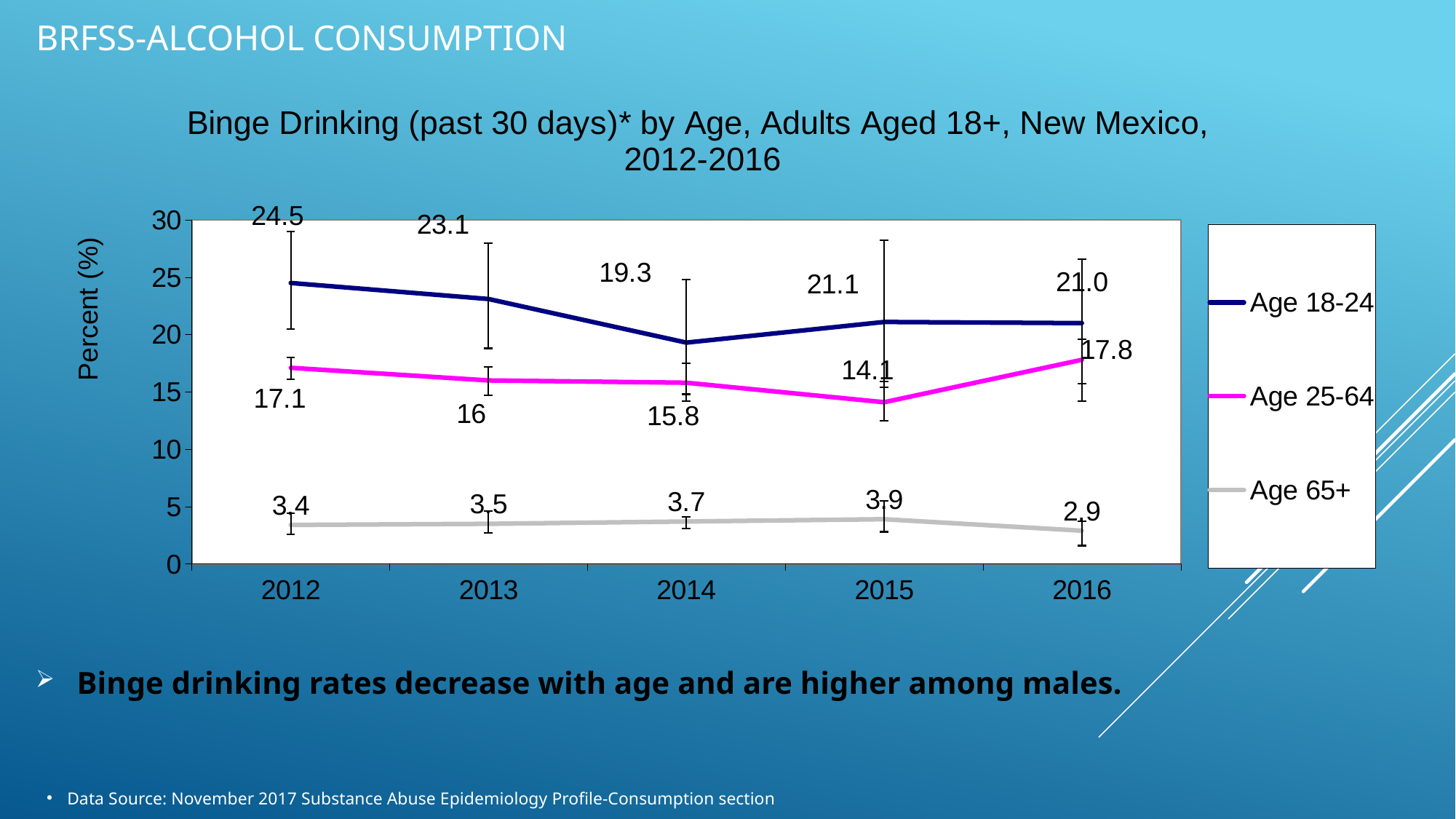
How many series does the legend list? 3 What was the binge drinking percentage for Age 25-64 in 2015? 14.1 Is the Age 25-64 value in 2012 greater or less than 15? greater What is the difference between the Age 18-24 and Age 25-64 values in 2016? 3.2 What was the binge drinking percentage for Age 18-24 in 2012? 24.5 In which year was the Age 18-24 value lowest? 2014 Which age group had the higher value in 2013: Age 18-24 or Age 25-64? Age 18-24 What was the binge drinking percentage for Age 65+ in 2016? 2.9 In which year was the Age 65+ value highest? 2015 What kind of chart is shown? line chart How many years are shown on the x axis? 5 What is the label on the y axis? Percent (%)